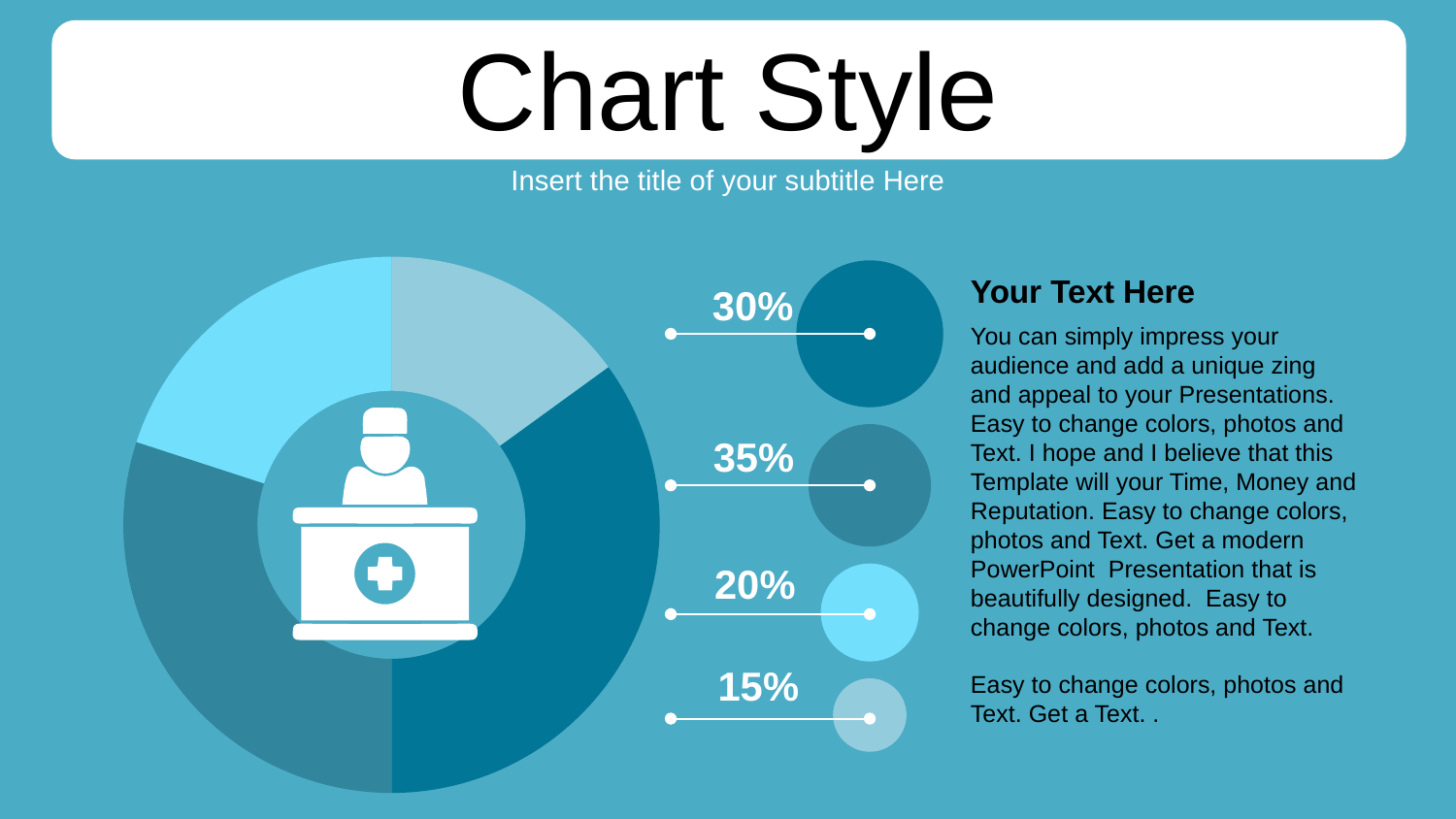
What is the largest percentage value labelled on the slide? 35% How many segments does the donut chart have? 4 What percentage is shown next to the bottom circle in the legend? 15% What percentage is shown next to the topmost circle in the legend? 30% How many percentage values are listed beside the donut chart? 4 What is the smallest percentage value labelled on the slide? 15% What is the title of the slide containing the chart? Chart Style What is the difference between the largest and smallest percentage values shown? 20% Which is larger, the value labelled 20% or the value labelled 15%? 20% What kind of chart is shown on the left of the slide? Pie chart (donut) What do the four percentage labels on the slide add up to? 100% What is the difference between the 35% and 30% values shown? 5%